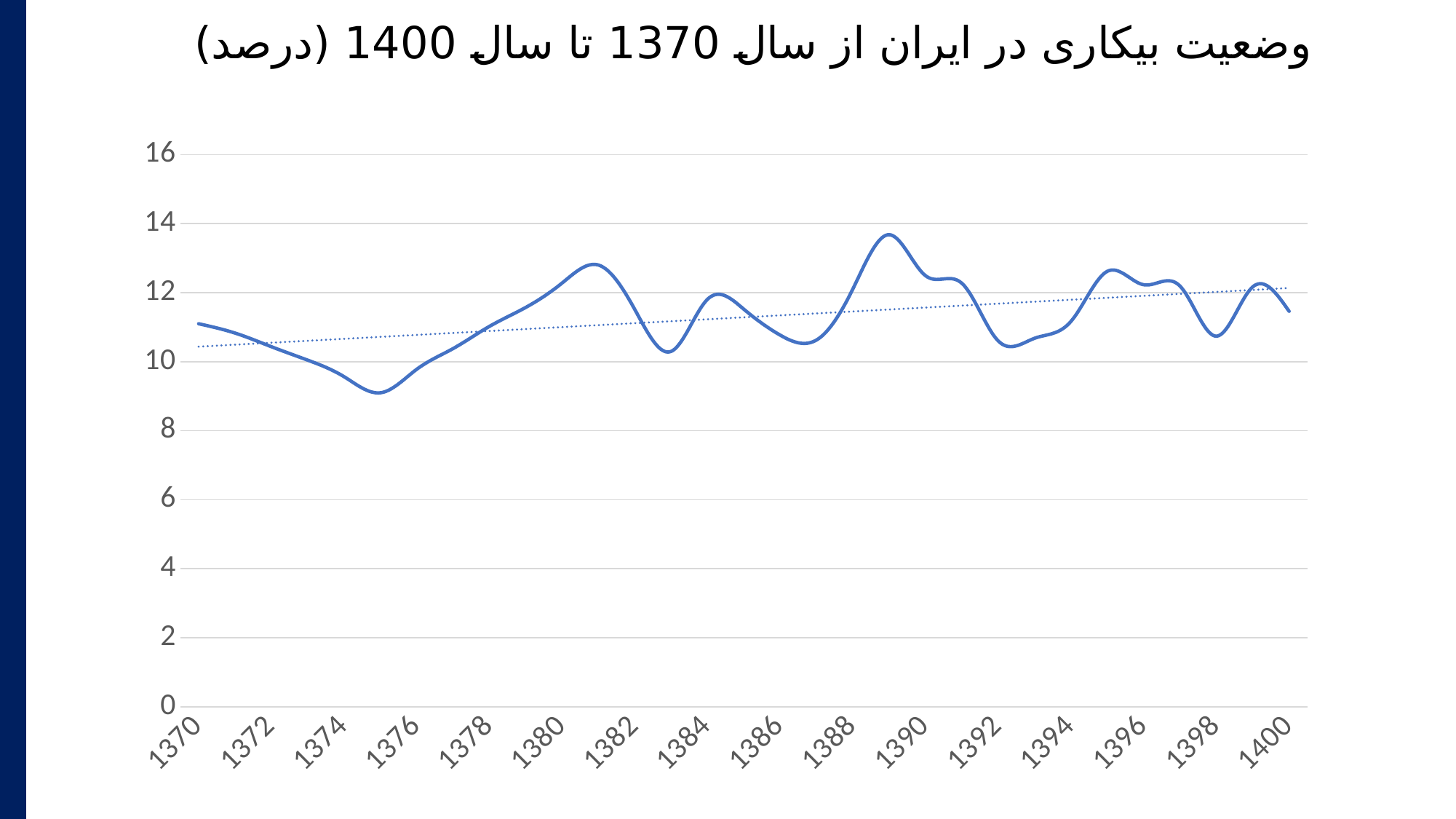
Is the value for 1392 greater or less than 12? less Between which two labelled years does the line reach its highest point? 1388 and 1390 Is the value for 1400 greater or less than 12? less How many year labels are shown on the x axis? 16 Which is larger, the value for 1380 or the value for 1376? 1380 What kind of chart is shown on the slide? line chart What is the highest value shown on the y axis? 16 Does the dotted trendline rise or fall from 1370 to 1400? rises Between which two labelled years does the line reach its lowest point? 1374 and 1376 Is the value for 1380 greater or less than 10? greater